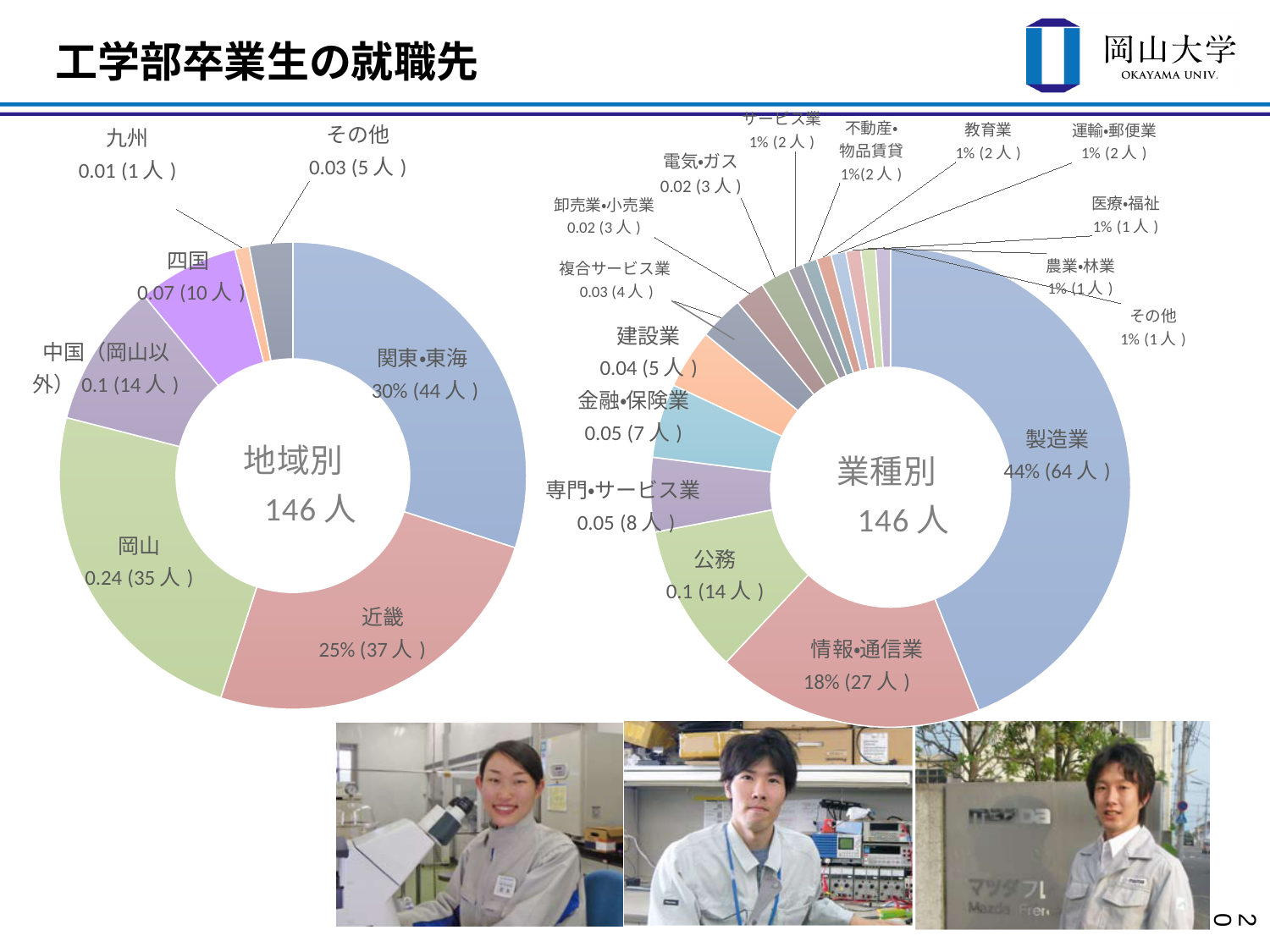
In the 地域別 chart, which region has the smallest share? 九州 In the 業種別 chart, what is the value shown for 製造業? 44% (64人) In the 地域別 chart, which region has the largest share? 関東•東海 In the 業種別 chart, which industry has the largest share? 製造業 In the 地域別 chart, how many people are in the 岡山 category? 35人 What type of chart is used on this slide? Pie (donut) chart In the 地域別 chart, how many categories are shown? 7 In the 地域別 chart, what is the value shown for 関東•東海? 30% (44人) In the 業種別 chart, how many more people are in 製造業 than in 情報•通信業? 37人 In the 業種別 chart, which is larger, 公務 or 建設業? 公務 In the 地域別 chart, how many more people went to 近畿 than to 岡山? 2人 In the 業種別 chart, how many people are in 情報•通信業? 27人